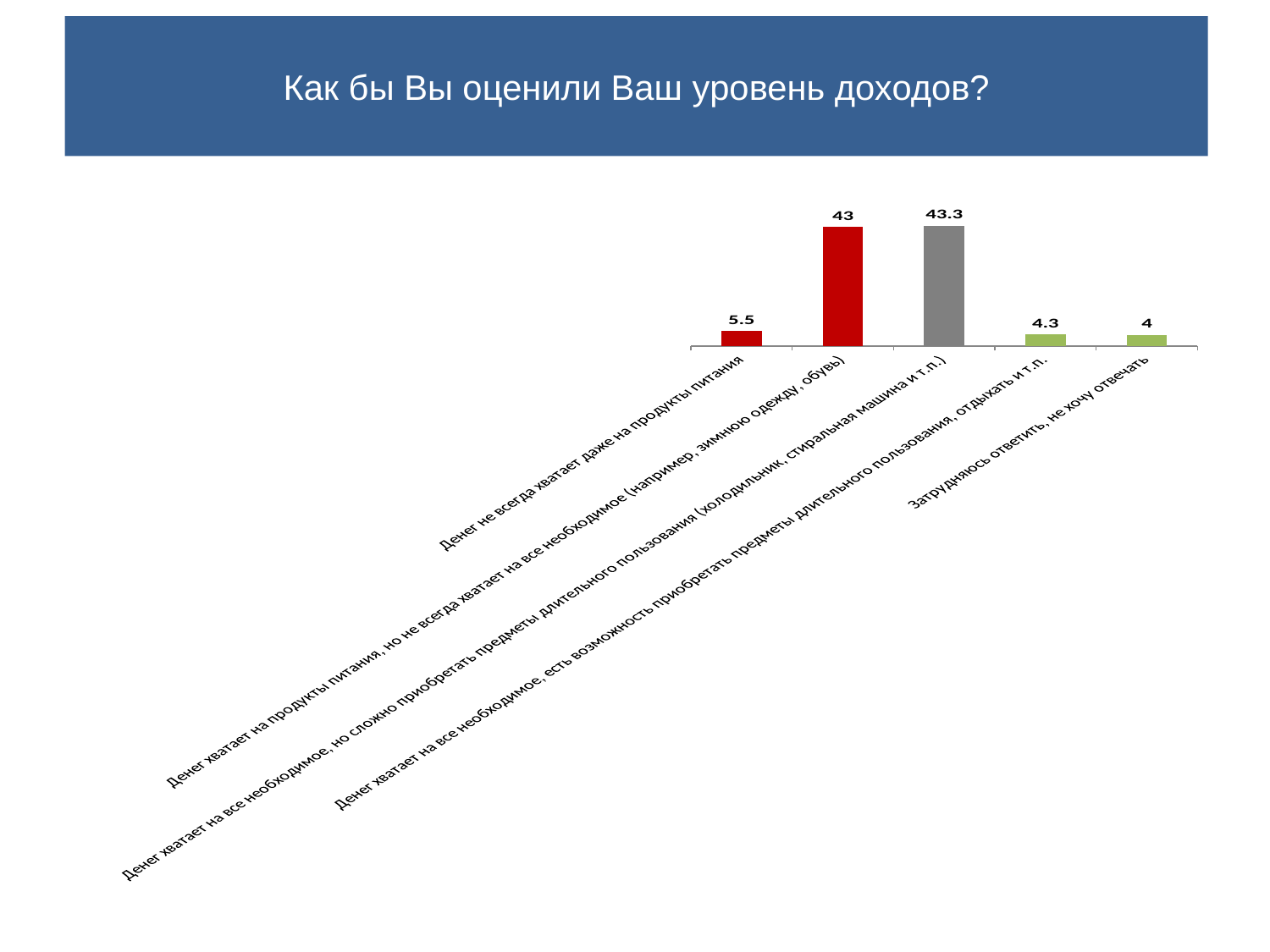
Which is larger: the value for "Денег не всегда хватает даже на продукты питания" or the value for "Затрудняюсь ответить, не хочу отвечать"? Денег не всегда хватает даже на продукты питания What kind of chart is shown on the slide? Bar chart What is the value for the category "Затрудняюсь ответить, не хочу отвечать"? 4 Which category has the highest value? Денег хватает на все необходимое, но сложно приобретать предметы длительного пользования (холодильник, стиральная машина и т.п.) What is the value for the category "Денег хватает на продукты питания, но не всегда хватает на все необходимое (например, зимнюю одежду, обувь)"? 43 Which category has the lowest value? Затрудняюсь ответить, не хочу отвечать How many categories are shown in the chart? 5 What is the value for the category "Денег хватает на все необходимое, есть возможность приобретать предметы длительного пользования, отдыхать и т.п."? 4.3 What is the difference between the values for "Денег не всегда хватает даже на продукты питания" and "Затрудняюсь ответить, не хочу отвечать"? 1.5 What is the difference between the values for "Денег хватает на все необходимое, но сложно приобретать предметы длительного пользования (холодильник, стиральная машина и т.п.)" and "Денег хватает на продукты питания, но не всегда хватает на все необходимое (например, зимнюю одежду, обувь)"? 0.3 What is the value for the category "Денег не всегда хватает даже на продукты питания"? 5.5 What is the title of the slide? Как бы Вы оценили Ваш уровень доходов?